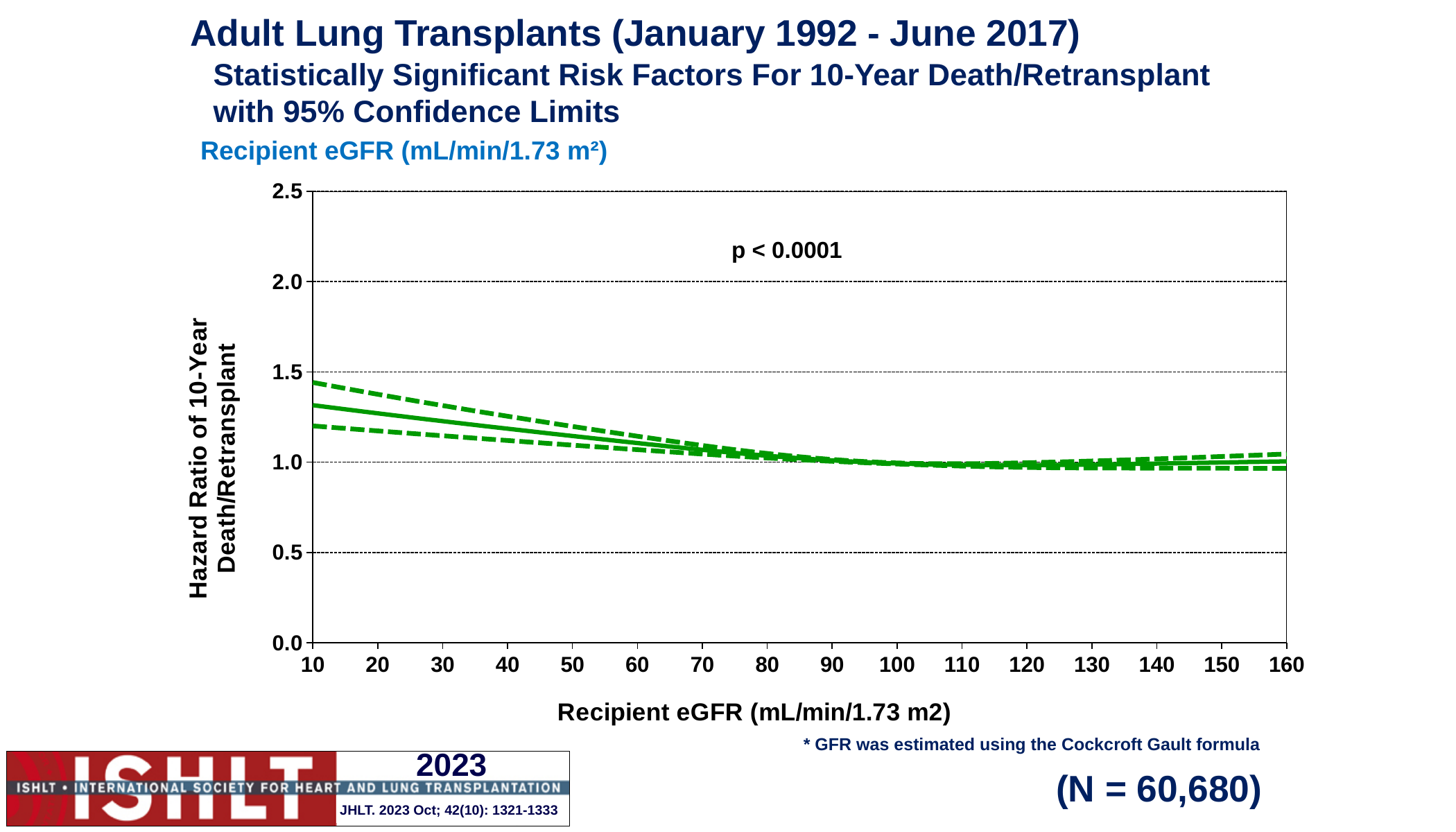
How many lines are plotted on the chart? 3 Is the upper confidence limit (upper dashed line) at a recipient eGFR of 10 greater or less than 1.5? less At which recipient eGFR value on the x axis is the hazard ratio (solid line) highest? 10 How many tick labels are shown on the x axis? 16 Is the hazard ratio (solid line) at a recipient eGFR of 40 greater or less than 1.0? greater Is the hazard ratio (solid line) at a recipient eGFR of 10 greater or less than 1.0? greater What is the label of the y axis? Hazard Ratio of 10-Year Death/Retransplant What kind of chart is shown on the slide? line chart Is the hazard ratio at a recipient eGFR of 10 larger or smaller than at a recipient eGFR of 100? larger Does the hazard ratio rise or fall as recipient eGFR increases from 10 to 100? fall What p-value is printed on the chart? p < 0.0001